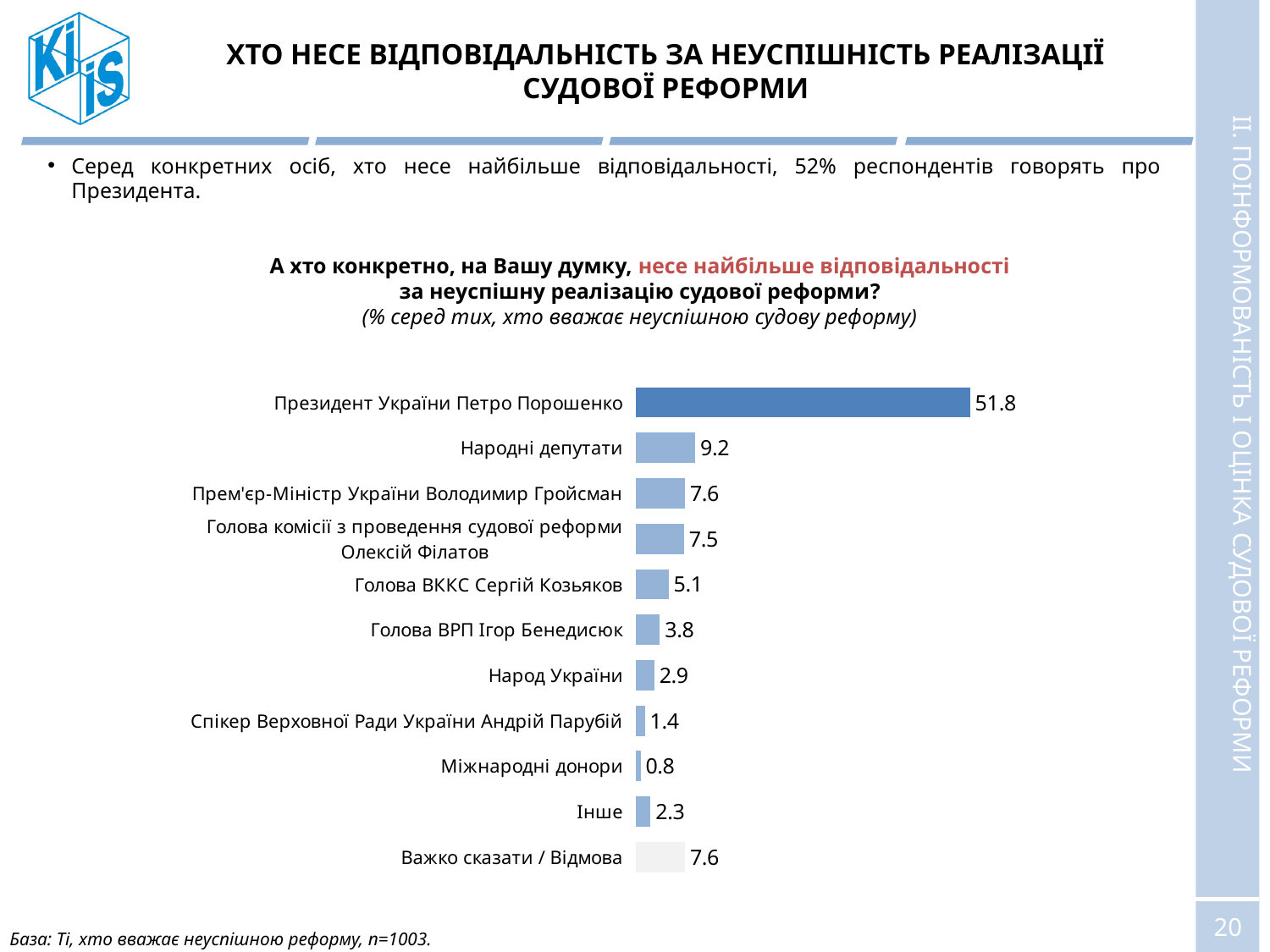
Which category has the lowest value? Міжнародні донори What value is shown for Голова ВККС Сергій Козьяков? 5.1 Which category has the highest value? Президент України Петро Порошенко What kind of chart is shown on the slide? Bar chart What is the difference between the values for Президент України Петро Порошенко and Народні депутати? 42.6 What value is shown for Президент України Петро Порошенко? 51.8 Which is larger, the value for Народні депутати or the value for Народ України? Народні депутати What is the difference between the values for Голова ВРП Ігор Бенедисюк and Народ України? 0.9 How many categories are shown in the chart? 11 What value is shown for Важко сказати / Відмова? 7.6 What is the value for Спікер Верховної Ради України Андрій Парубій? 1.4 What value is shown for Народні депутати? 9.2